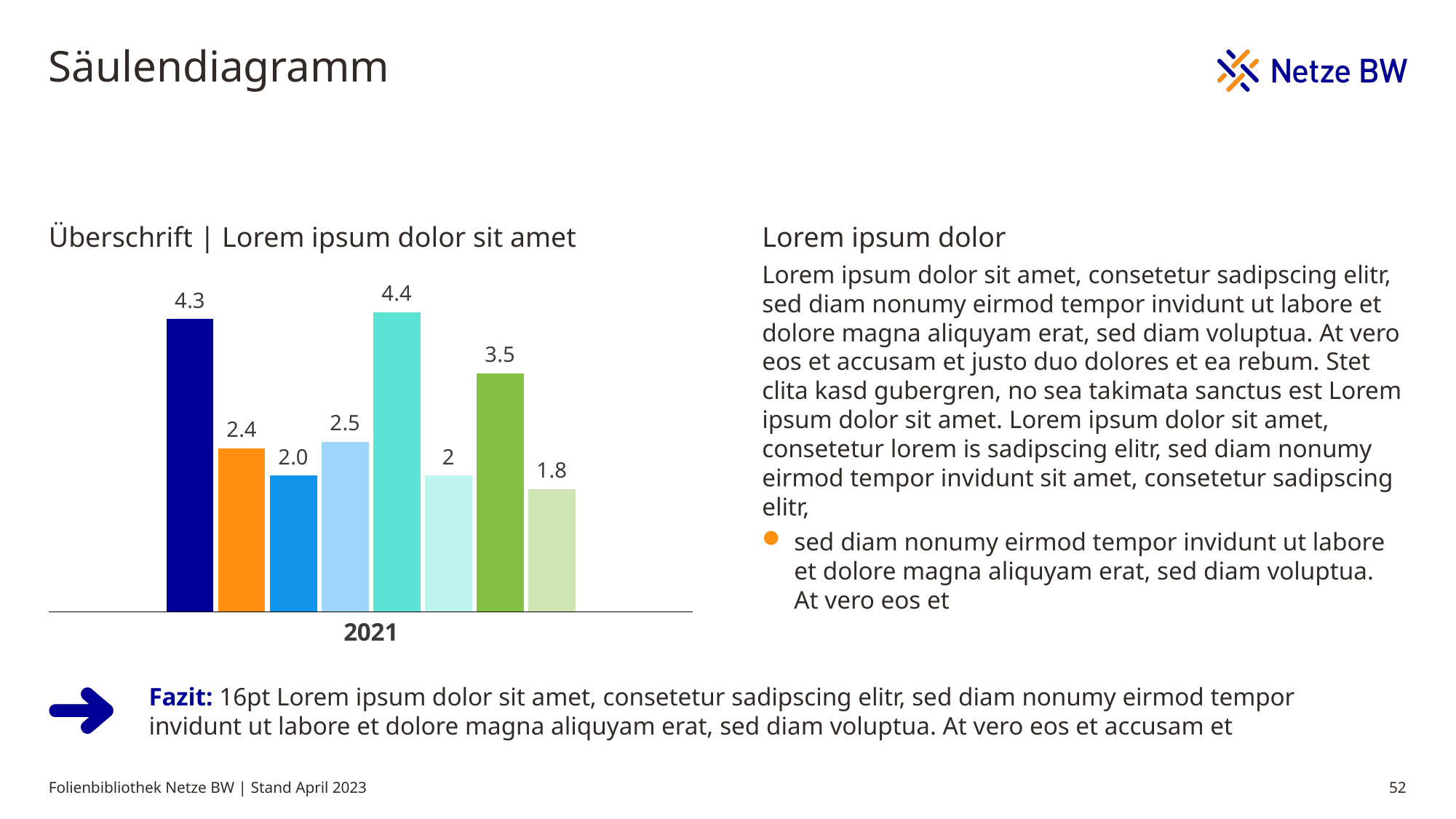
What is the value of the green bar (seventh from the left) in the chart? 3.5 Which is larger, the first bar (4.3) or the green bar (3.5)? the first bar (4.3) What is the value of the first (dark blue) bar in the chart? 4.3 What kind of chart is shown on the slide? bar chart What is the difference between the first bar (4.3) and the last bar (1.8)? 2.5 What is the category label shown on the x axis of the chart? 2021 What is the difference between the highest bar (4.4) and the first bar (4.3)? 0.1 How many bars are plotted in the chart? 8 What is the highest value shown in the chart? 4.4 What is the value of the orange bar in the chart? 2.4 What is the lowest value shown in the chart? 1.8 What is the title of the chart? Überschrift | Lorem ipsum dolor sit amet